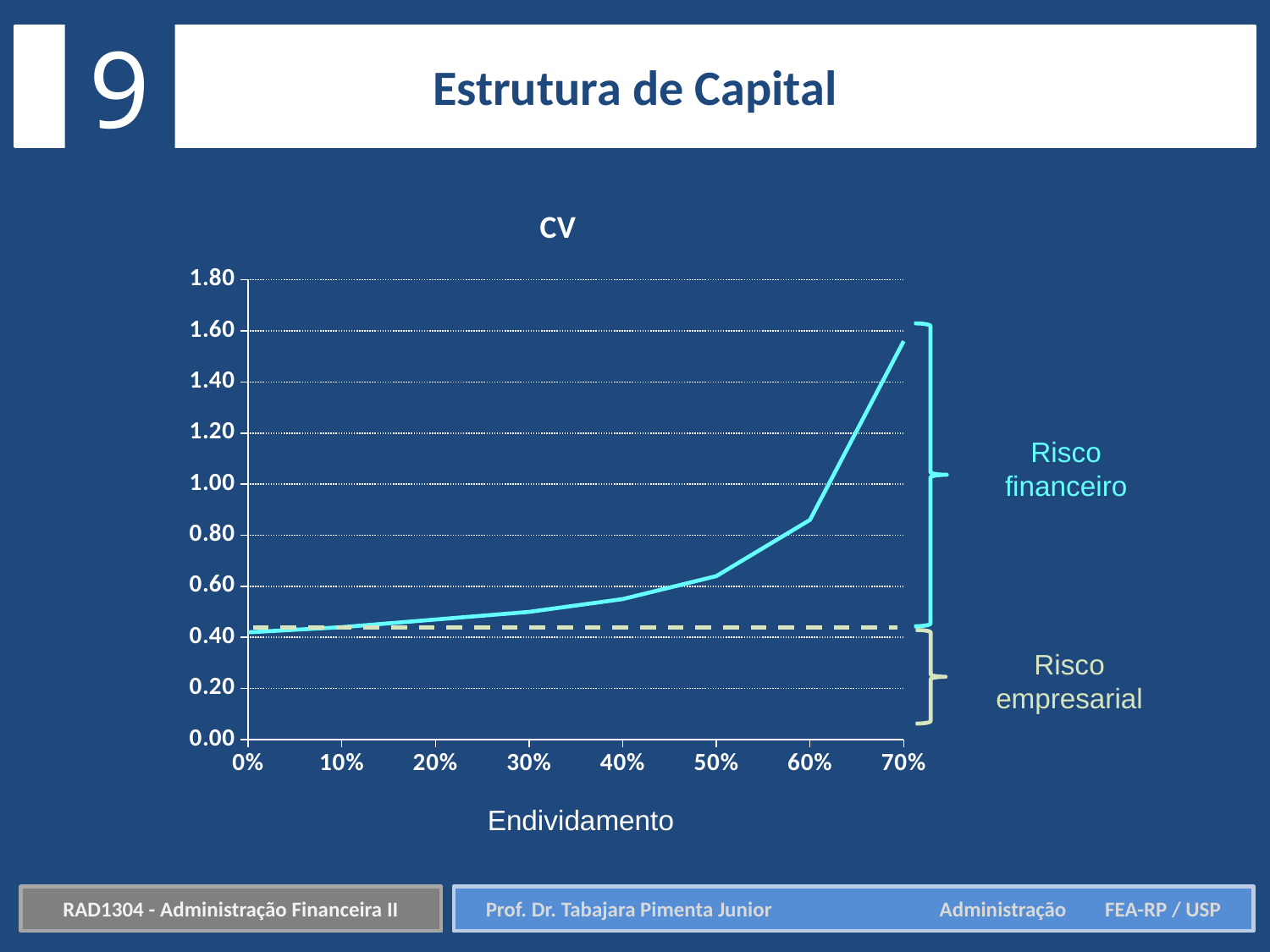
Which has the larger value on the solid line: 60% or 50% Endividamento? 60% Is the value of the solid line at 60% greater or less than 1.00? less How many Endividamento levels are marked on the x axis? 8 What is the title of the chart? CV What is the label of the x axis? Endividamento Is the value of the solid line at 0% greater or less than 0.60? less Does the solid line rise or fall as Endividamento increases from 0% to 70%? rises Is the value of the solid line at 70% greater or less than 1.40? greater What kind of chart is shown on the slide? line chart At which Endividamento level is the solid line highest? 70% At which Endividamento level is the solid line lowest? 0%